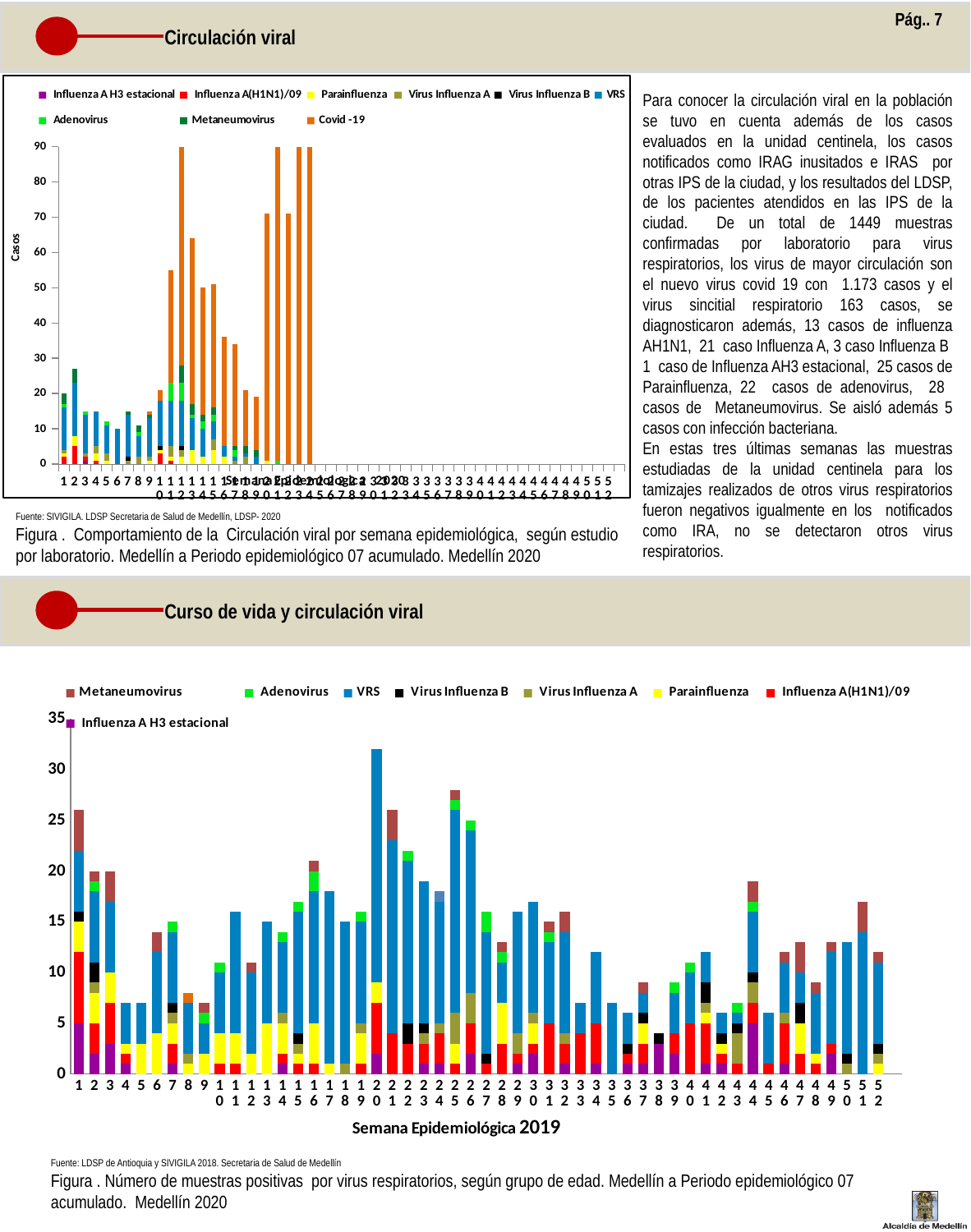
What kind of chart is the top chart titled 'Circulación viral'? Stacked bar chart In the top chart, is the total for week 1 greater or less than 30? less In the bottom chart, how many epidemiological weeks are shown on the x axis? 52 In the bottom chart, is the total for week 1 greater or less than 20? greater In the bottom chart, is the total for week 20 greater or less than 30? greater What kind of chart is the bottom chart under 'Curso de vida y circulación viral'? Stacked bar chart In the bottom chart, which epidemiological week has the tallest stacked bar? Week 20 How many series does the legend of the bottom chart list? 8 How many series does the legend of the top chart list? 9 In the top chart, what is the label of the vertical axis? Casos In the bottom chart, what is the label of the horizontal axis? Semana Epidemiológica 2019